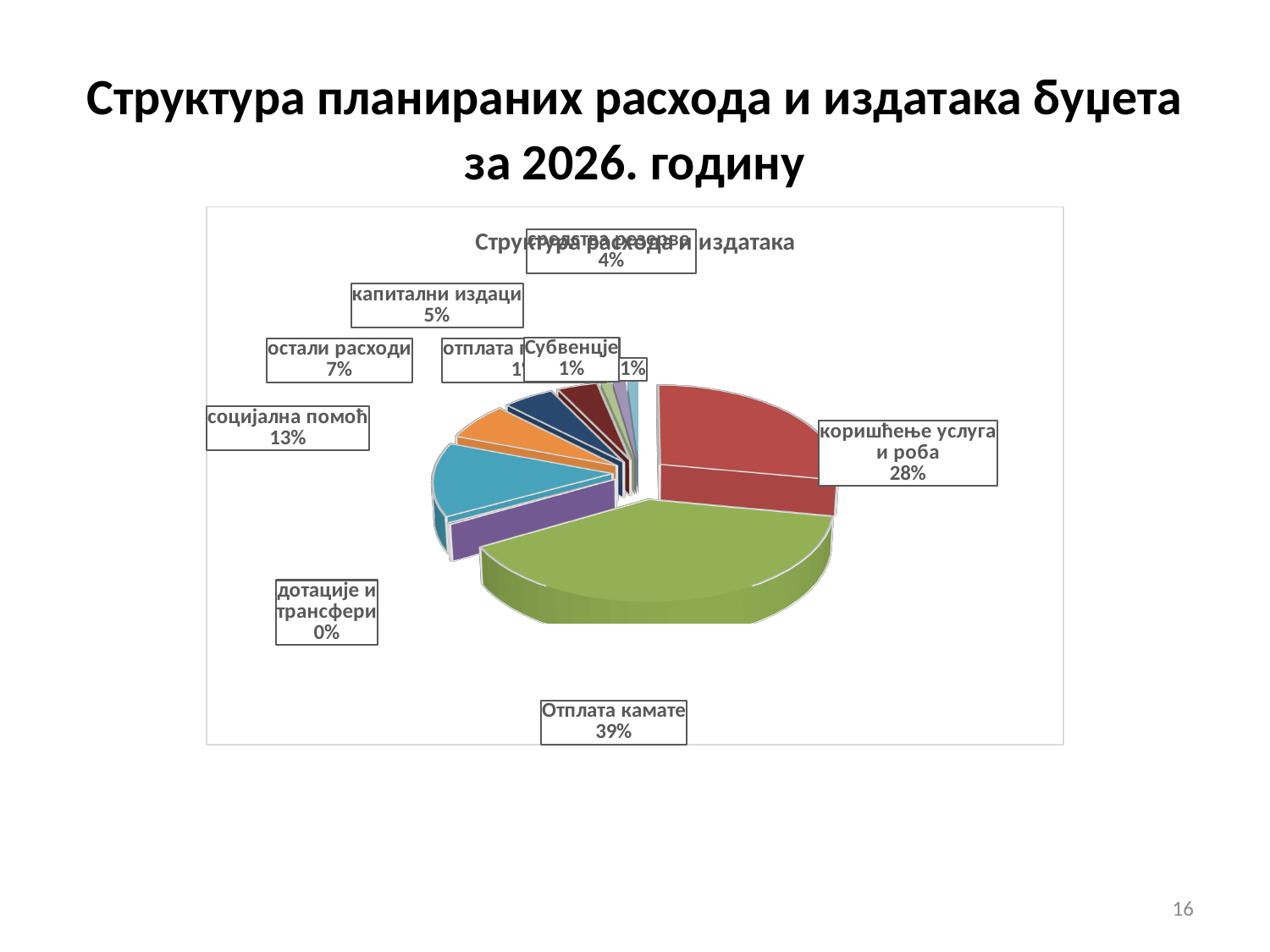
What is the difference in percentage points between Отплата камате and коришћење услуга и роба? 11 Which category has the largest share of the pie? Отплата камате What is the title of the chart? Структура расхода и издатака What kind of chart is shown on the slide? pie chart What percentage is shown for дотације и трансфери? 0% What share of the pie does Отплата камате have? 39% What percentage is shown for остали расходи? 7% What percentage is shown for средства резерве? 4% What share of the pie does коришћење услуга и роба have? 28% What percentage is shown for капитални издаци? 5% Which category has the smallest share of the pie? дотације и трансфери What percentage is shown for социјална помоћ? 13%